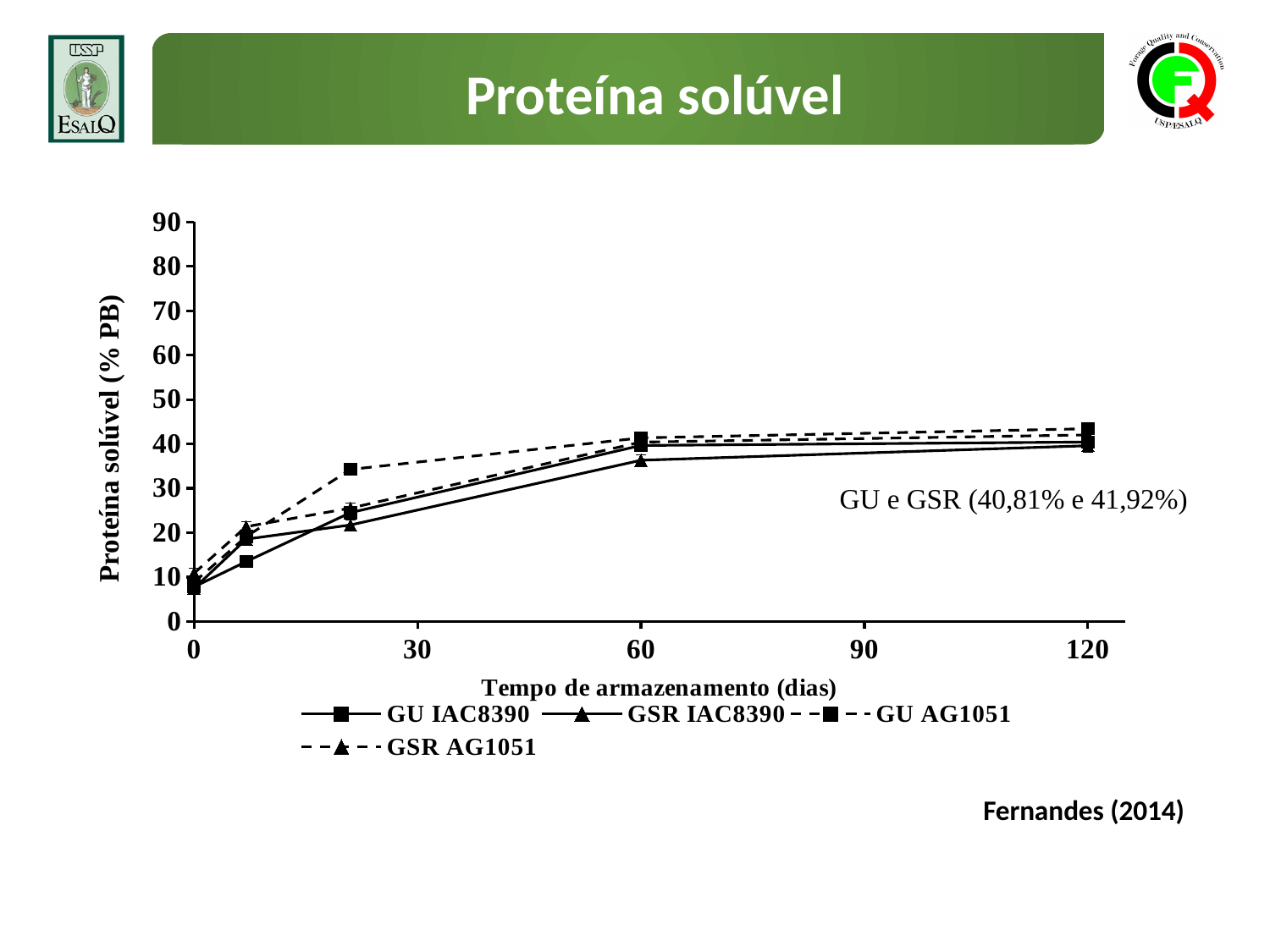
Do the values for GU IAC8390 rise or fall as storage time increases along the x axis? rise How many data points are plotted for each series? 5 What values does the annotation on the chart give for GU and GSR? 40,81% e 41,92% What is the title of the y axis? Proteína solúvel (% PB) At 60 days, which is larger: GU AG1051 or GSR IAC8390? GU AG1051 What kind of chart is shown on the slide? line chart What is the title of the x axis? Tempo de armazenamento (dias) Is the value for GU IAC8390 at 120 days greater or less than 50? less Is the value for GU AG1051 at 60 days greater or less than 30? greater How many series does the legend list? 4 Is the value for GSR IAC8390 at 0 days greater or less than 20? less Which series has the lowest value at 60 days? GSR IAC8390